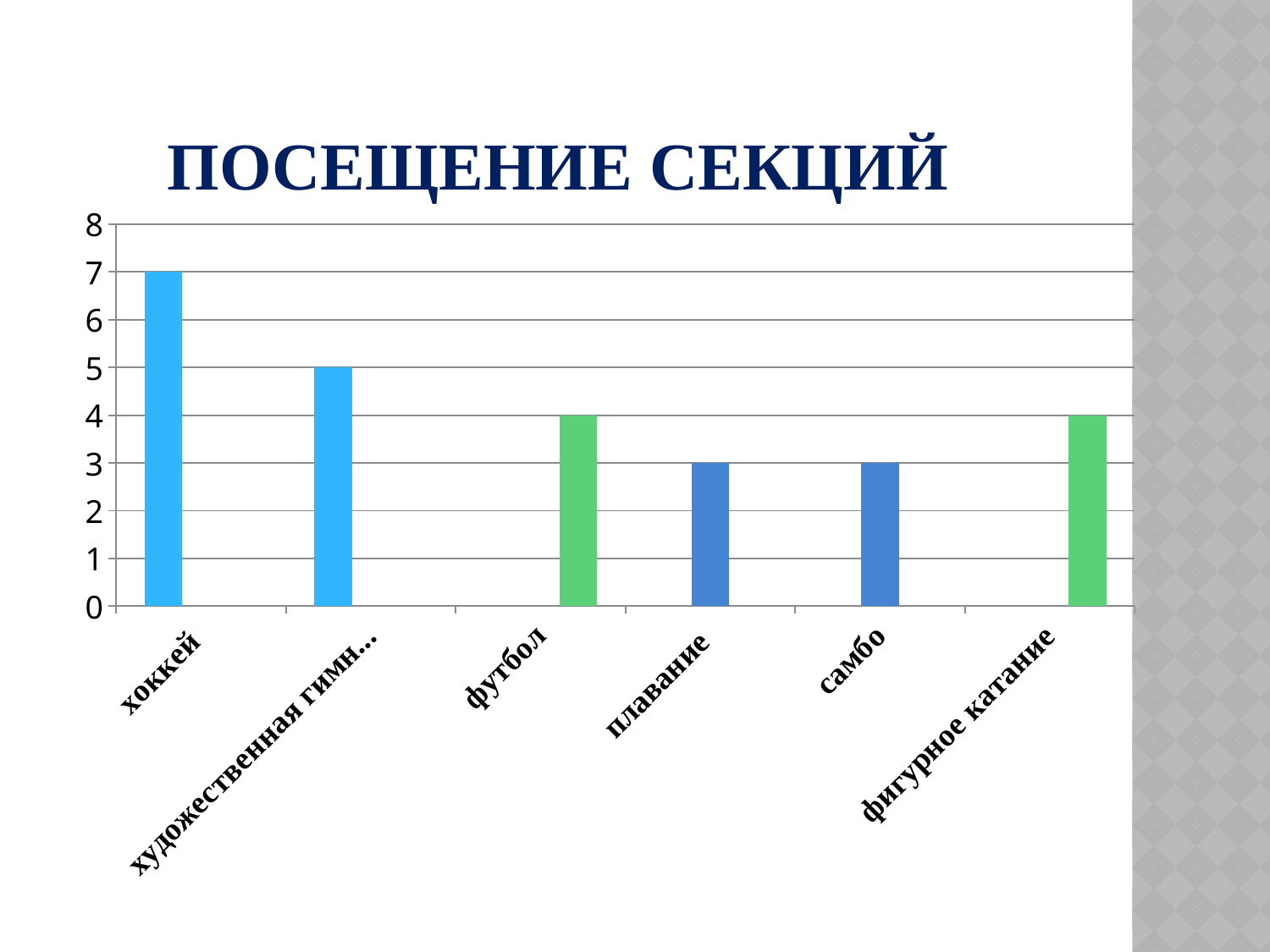
How many categories are shown on the x axis? 6 What is the difference between the values for хоккей and футбол? 3 What is the value for плавание? 3 What is the value for хоккей? 7 Which is larger, the value for хоккей or the value for самбо? хоккей What kind of chart is this? bar chart What is the value for футбол? 4 What is the title of the chart? ПОСЕЩЕНИЕ СЕКЦИЙ Which category has the highest value? хоккей What is the value for фигурное катание? 4 What is the value for the second category from the left (художественная гимн...)? 5 What is the value for самбо? 3